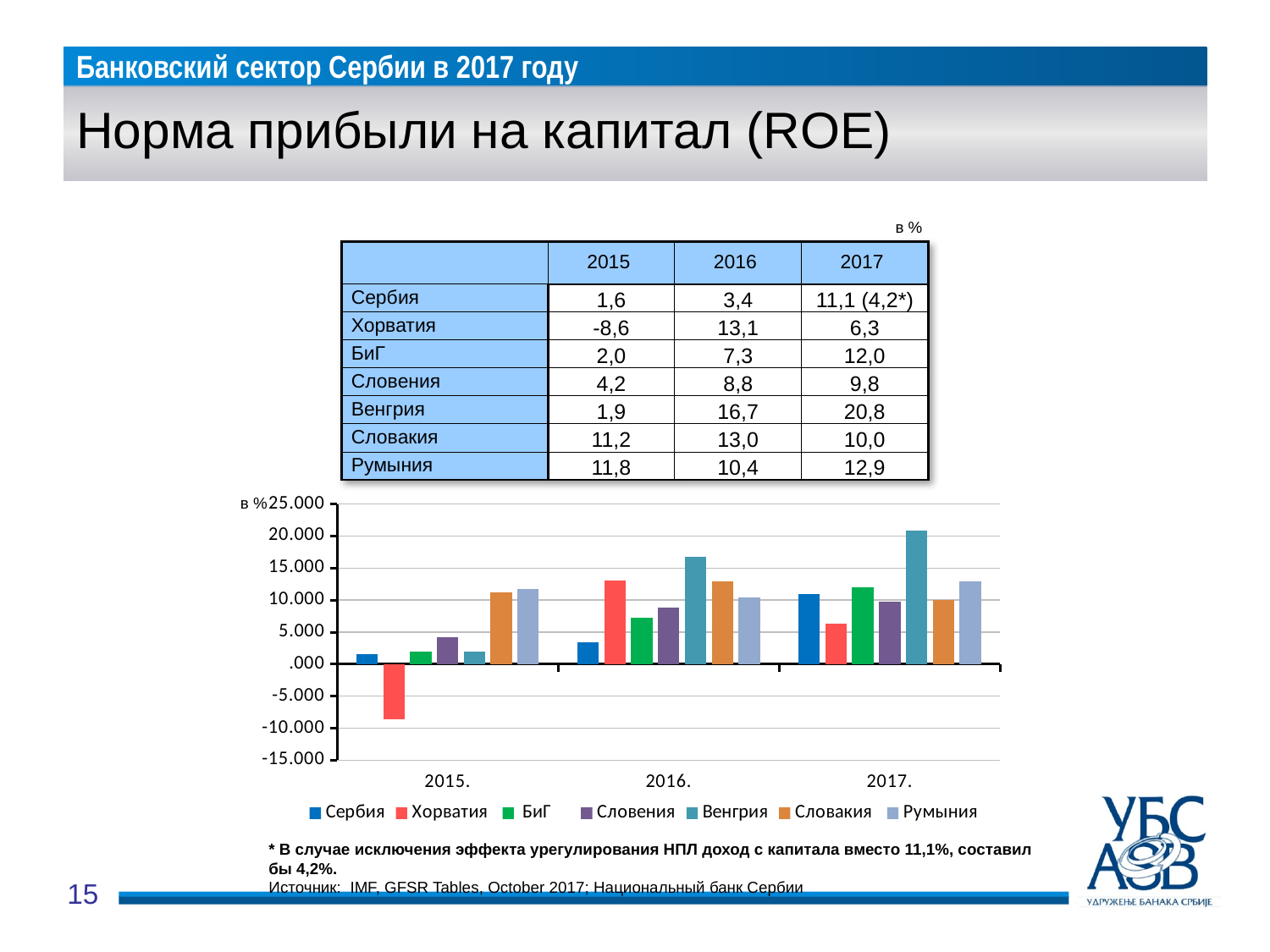
What is the ROE value for Венгрия in 2017? 20,8 By how much did the ROE of Венгрия increase from 2016 to 2017? 4,1 In 2016, which has the larger ROE: Хорватия or Словения? Хорватия What is the ROE value for Румыния in 2015? 11,8 How many year categories are shown on the x axis of the chart? 3 Which country has the highest ROE in 2017? Венгрия What kind of chart is shown on the slide? bar chart What colour represents Хорватия in the chart legend? red Does the ROE of Сербия rise or fall from 2015 to 2017? rises Is the value for Хорватия in 2015 greater or less than -5.000? less Which country has the lowest ROE in 2015? Хорватия How many series does the chart legend list? 7